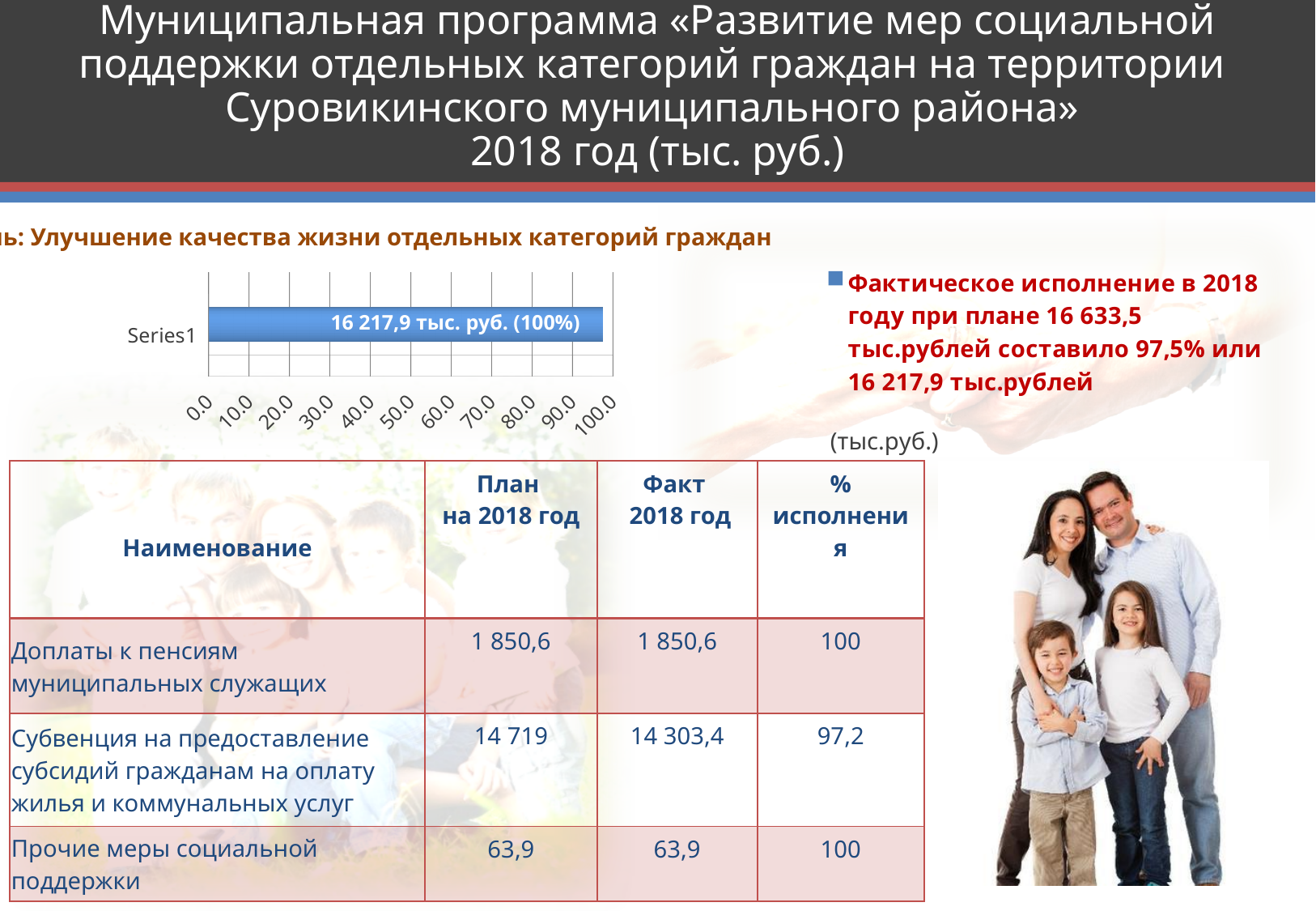
What is the category label shown on the vertical axis of the chart? Series1 What is the highest tick value shown on the x axis of the chart? 100.0 How many bars does the chart contain? 1 What kind of chart is shown on the slide? bar chart What is the lowest tick value shown on the x axis of the chart? 0.0 Is the bar in the chart oriented horizontally or vertically? horizontally What is the data label printed on the bar in the chart? 16 217,9 тыс. руб. (100%) What percentage is shown in the data label on the bar? 100% Is the value for Series1 greater or less than 90.0 on the x axis? greater